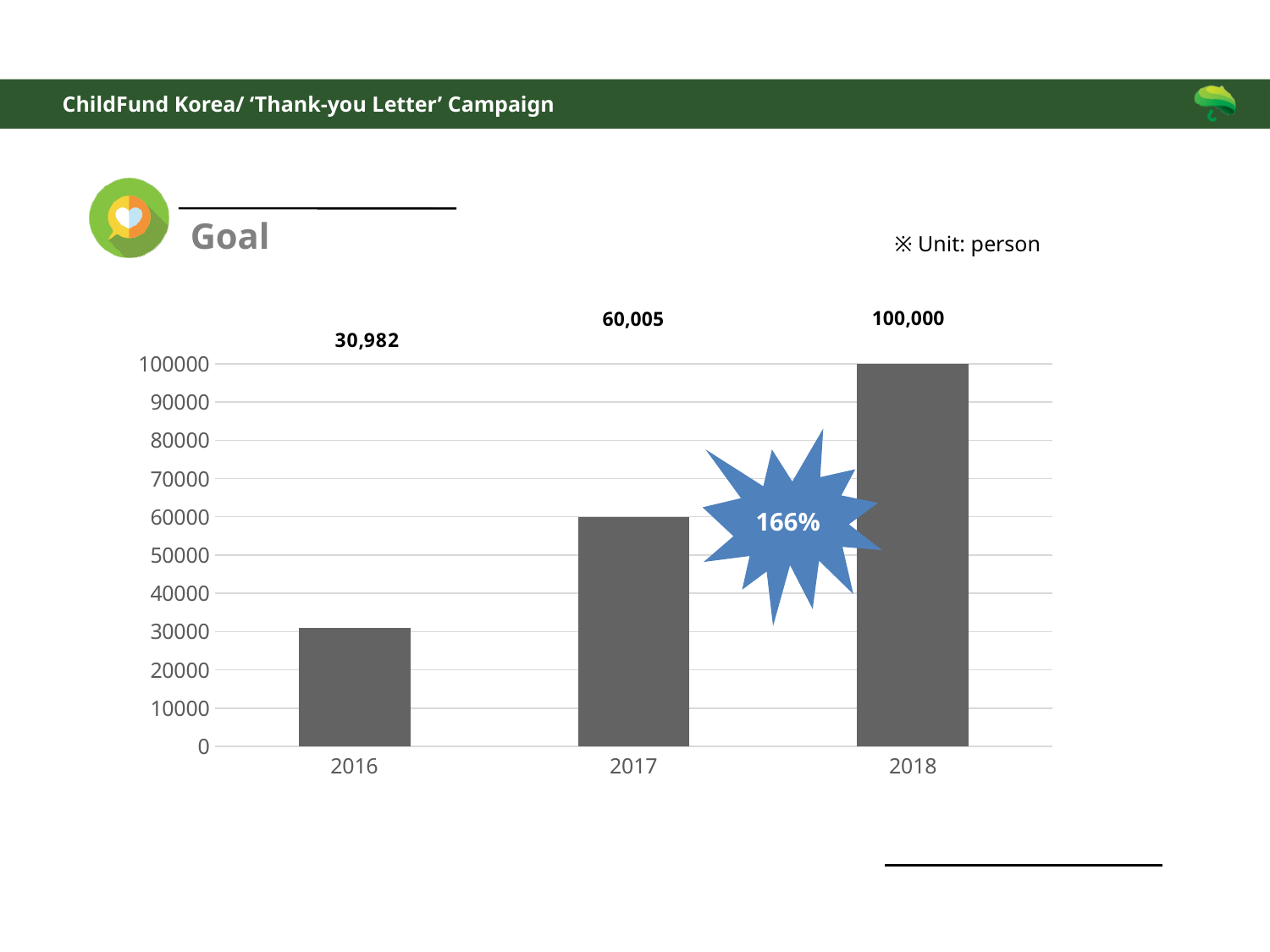
What is the value for 2016? 30,982 What is the value for 2018? 100,000 Which year has the highest value? 2018 Which is larger, the value for 2016 or the value for 2017? 2017 What kind of chart is shown on the slide? bar chart Which year has the lowest value? 2016 What is the value for 2017? 60,005 What is the difference between the values for 2018 and 2017? 39,995 What is the difference between the values for 2017 and 2016? 29,023 How many years are shown on the x axis? 3 Do the values rise or fall from 2016 to 2018? rise Is the value for 2016 greater or less than 40000? less